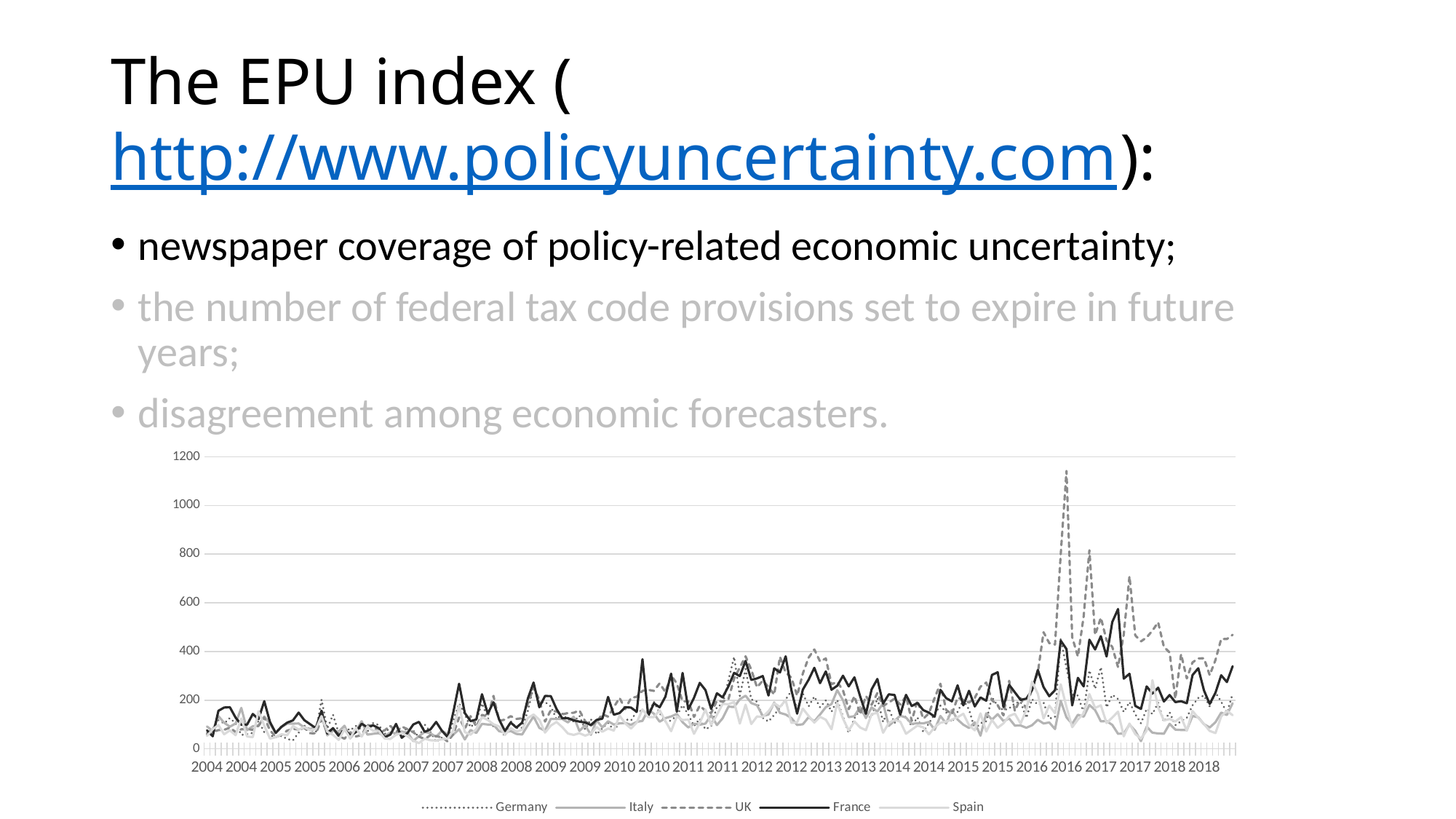
Which series is drawn as a dotted line in the legend? Germany Is the value for France at the start of 2004 greater or less than 200? less What is the last year shown on the x axis? 2018 Which series reaches the highest value on the chart? UK Do the index values generally rise or fall from 2004 to 2018? rise In which year does the UK series reach its highest peak? 2016 How many series does the chart legend list? 5 What is the highest value shown on the y axis? 1200 What is the first year shown on the x axis? 2004 Is the peak value of the France series greater or less than 400? greater Is the peak value of the UK series greater or less than 1000? greater What kind of chart is shown on the slide? line chart